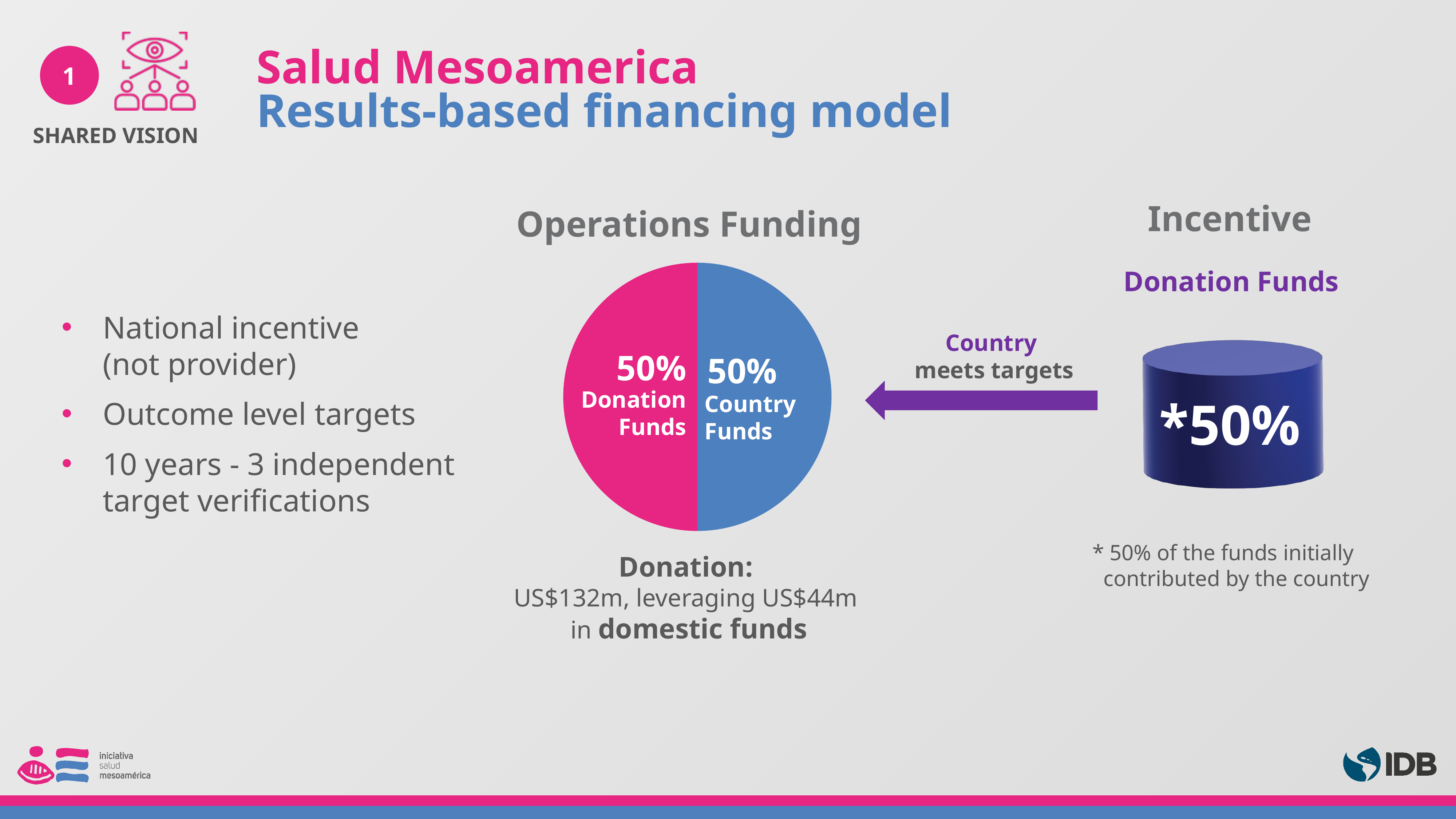
What is the title shown above the pie chart? Operations Funding What is the difference between the Donation Funds share and the Country Funds share in the Operations Funding pie chart? 0% Is the Donation Funds share in the Operations Funding pie chart greater or less than 25%? greater What kind of chart is shown under the heading "Operations Funding"? pie chart How many slices does the Operations Funding pie chart have? 2 In the Operations Funding pie chart, what share is labelled for Donation Funds? 50% According to the text below the Operations Funding pie chart, what is the donation amount? US$132m Is the Country Funds share in the Operations Funding pie chart greater or less than 75%? less What do the two slices of the Operations Funding pie chart add up to? 100% According to the text below the Operations Funding pie chart, how much in domestic funds does the donation leverage? US$44m In the Operations Funding pie chart, what share is labelled for Country Funds? 50% What colour is the Donation Funds slice in the Operations Funding pie chart? pink